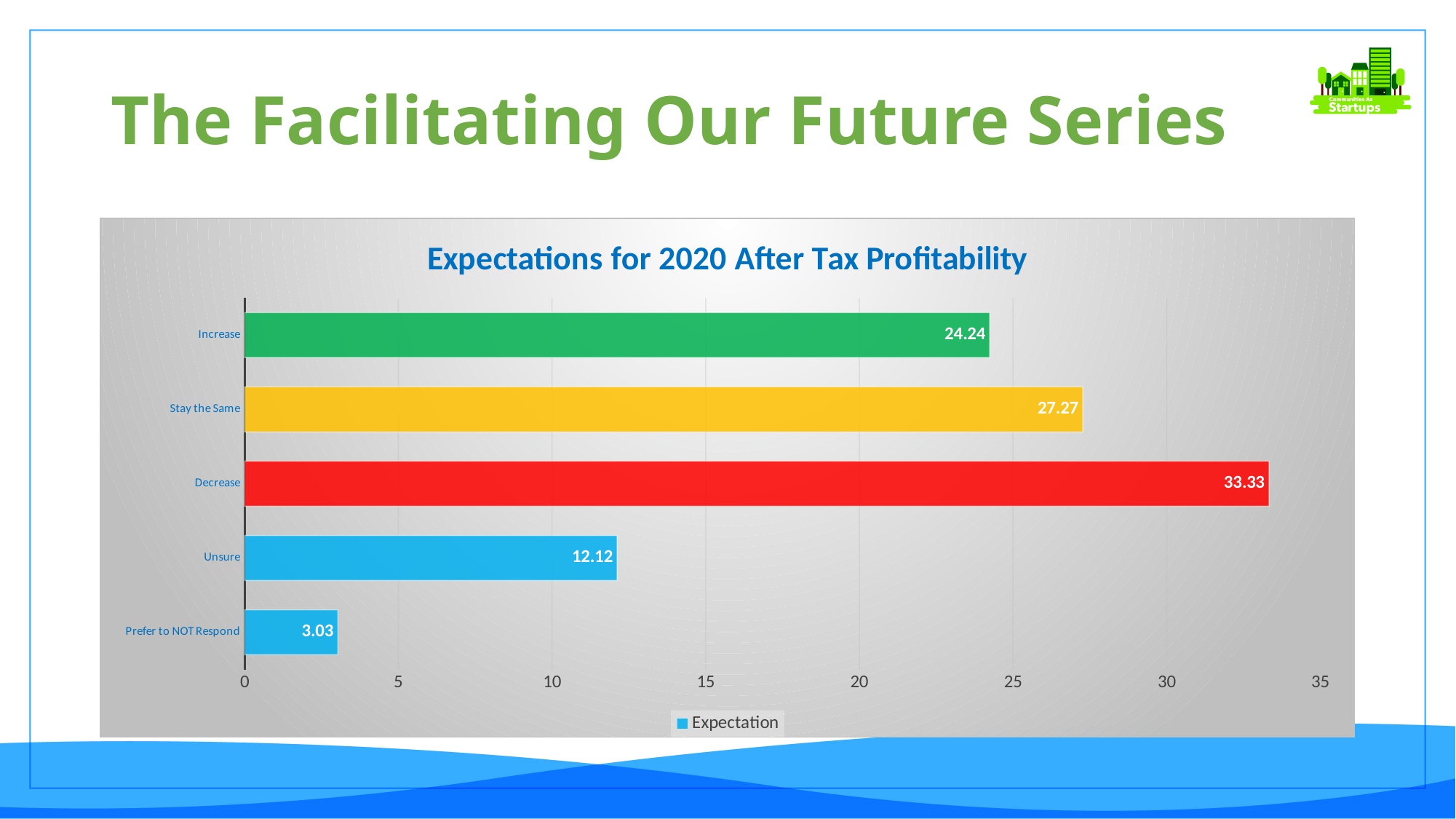
What is the title of the chart? Expectations for 2020 After Tax Profitability How many categories are shown in the chart? 5 What is the value for Stay the Same? 27.27 What kind of chart is shown? bar chart How many series does the legend list? 1 What is the value for Decrease? 33.33 What is the value for Prefer to NOT Respond? 3.03 Which category has the highest value? Decrease Which is larger, the value for Stay the Same or the value for Unsure? Stay the Same What is the difference between the values for Decrease and Increase? 9.09 Which category has the lowest value? Prefer to NOT Respond Is the value for Increase greater or less than 20? greater